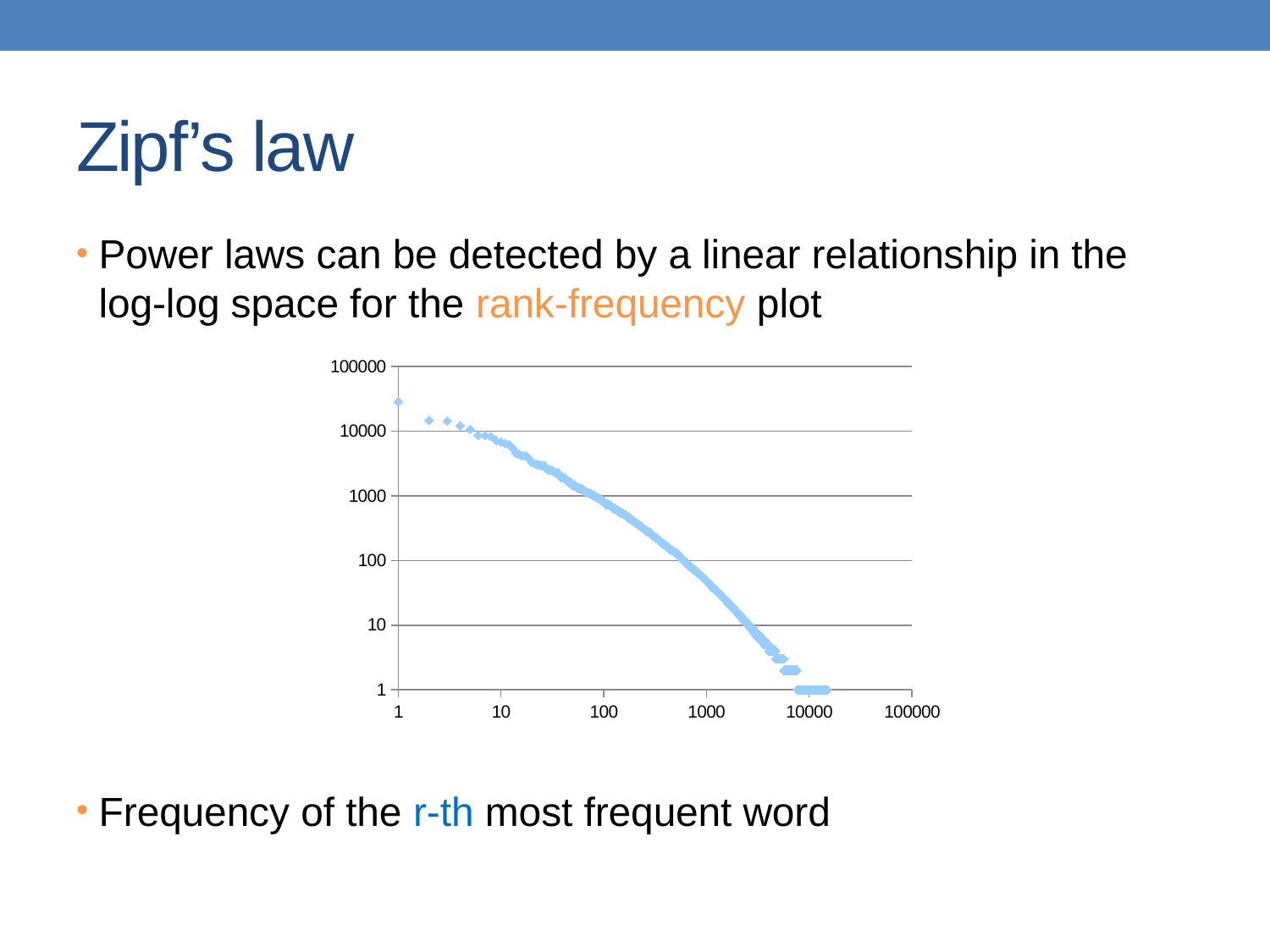
Is the value plotted at rank 10 greater or less than 1000? greater What is the highest tick label shown on the y axis? 100000 What kind of chart is shown on the slide? scatter chart Is the value plotted at rank 1 greater or less than 10000? greater Which of the plotted points has the highest value: the one at rank 1 or the one at rank 100? rank 1 Is the value plotted at rank 1 greater or less than 100000? less What colour are the plotted points in the chart? light blue Do the plotted values rise or fall as rank increases along the x axis? fall